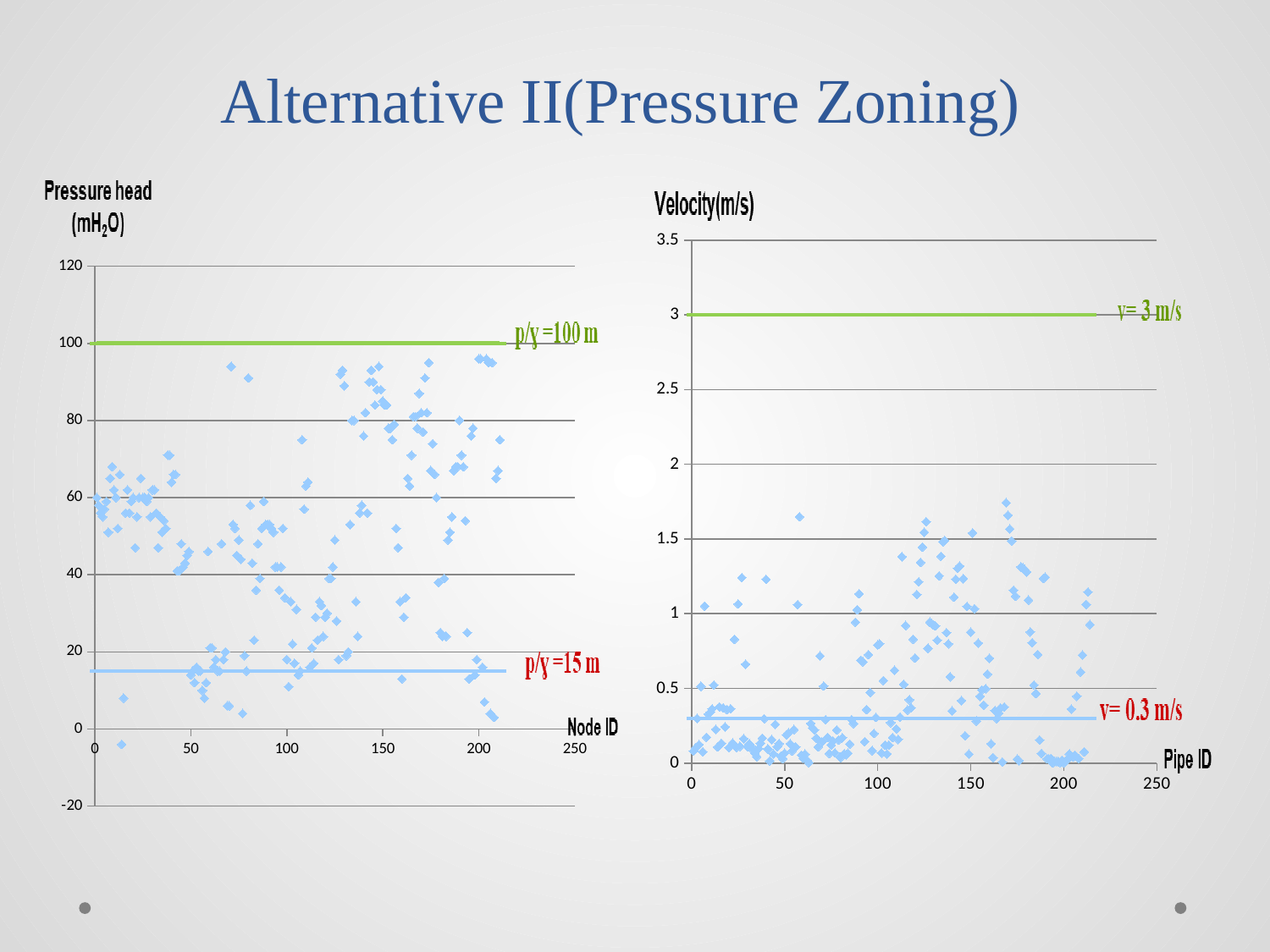
What is the highest value shown on the y axis of the Velocity chart on the right? 3.5 On the Pressure head chart on the left, is the highest plotted pressure head greater or less than 100? less What is the x-axis label of the Velocity chart on the right? Pipe ID What kind of chart is the Velocity chart on the right? scatter chart On the Velocity chart on the right, what value does the lower blue reference line mark? v = 0.3 m/s What is the x-axis label of the Pressure head chart on the left? Node ID On the Velocity chart on the right, is the highest plotted velocity greater or less than 2? less On the Velocity chart on the right, is the highest plotted velocity greater or less than 1.5? greater What kind of chart is the Pressure head chart on the left? scatter chart On the Pressure head chart on the left, what value does the lower blue reference line mark? p/γ = 15 m On the Pressure head chart on the left, what value does the upper green reference line mark? p/γ = 100 m On the Velocity chart on the right, what value does the upper green reference line mark? v = 3 m/s